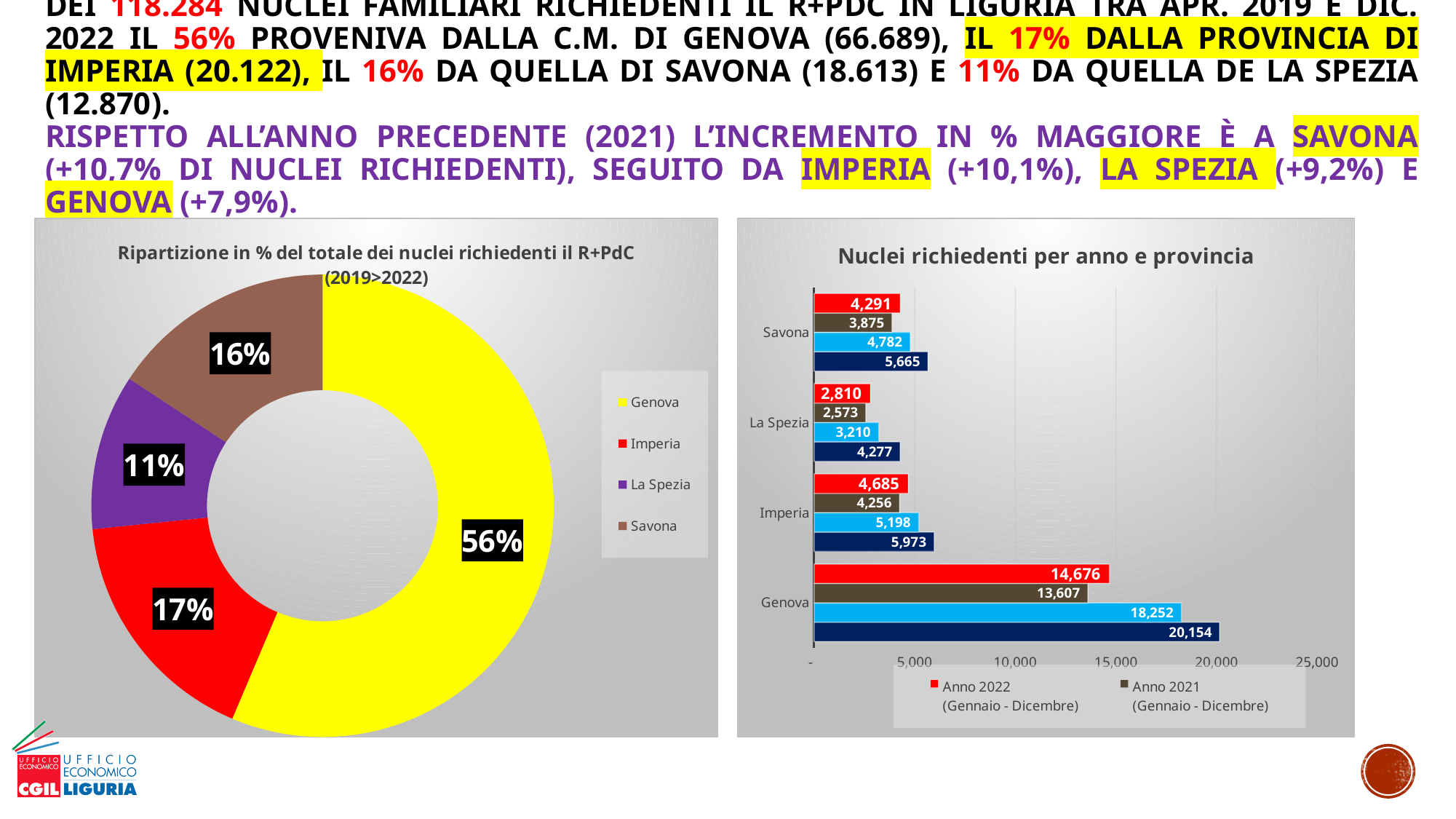
What kind of chart is the one titled 'Nuclei richiedenti per anno e provincia'? Bar chart In the chart titled 'Nuclei richiedenti per anno e provincia', which province has the lowest Anno 2021 value? La Spezia In the chart titled 'Nuclei richiedenti per anno e provincia', what is the difference between the Anno 2022 and Anno 2021 values for Imperia? 429 What kind of chart is the one on the left of the slide? Doughnut (pie) chart In the chart titled 'Nuclei richiedenti per anno e provincia', what is the Anno 2021 value for Genova? 13,607 In the chart titled 'Nuclei richiedenti per anno e provincia', which province has the highest Anno 2022 value? Genova In the chart titled 'Ripartizione in % del totale dei nuclei richiedenti il R+PdC (2019>2022)', what share does La Spezia have? 11% In the chart titled 'Nuclei richiedenti per anno e provincia', what is the Anno 2022 value for Savona? 4,291 In the chart titled 'Ripartizione in % del totale dei nuclei richiedenti il R+PdC (2019>2022)', what share does Genova have? 56% In the chart titled 'Nuclei richiedenti per anno e provincia', is the Anno 2022 value for Imperia larger or smaller than the Anno 2022 value for Savona? Larger In the chart titled 'Ripartizione in % del totale dei nuclei richiedenti il R+PdC (2019>2022)', which province has the smallest share? La Spezia In the chart titled 'Ripartizione in % del totale dei nuclei richiedenti il R+PdC (2019>2022)', how many provinces are shown? 4